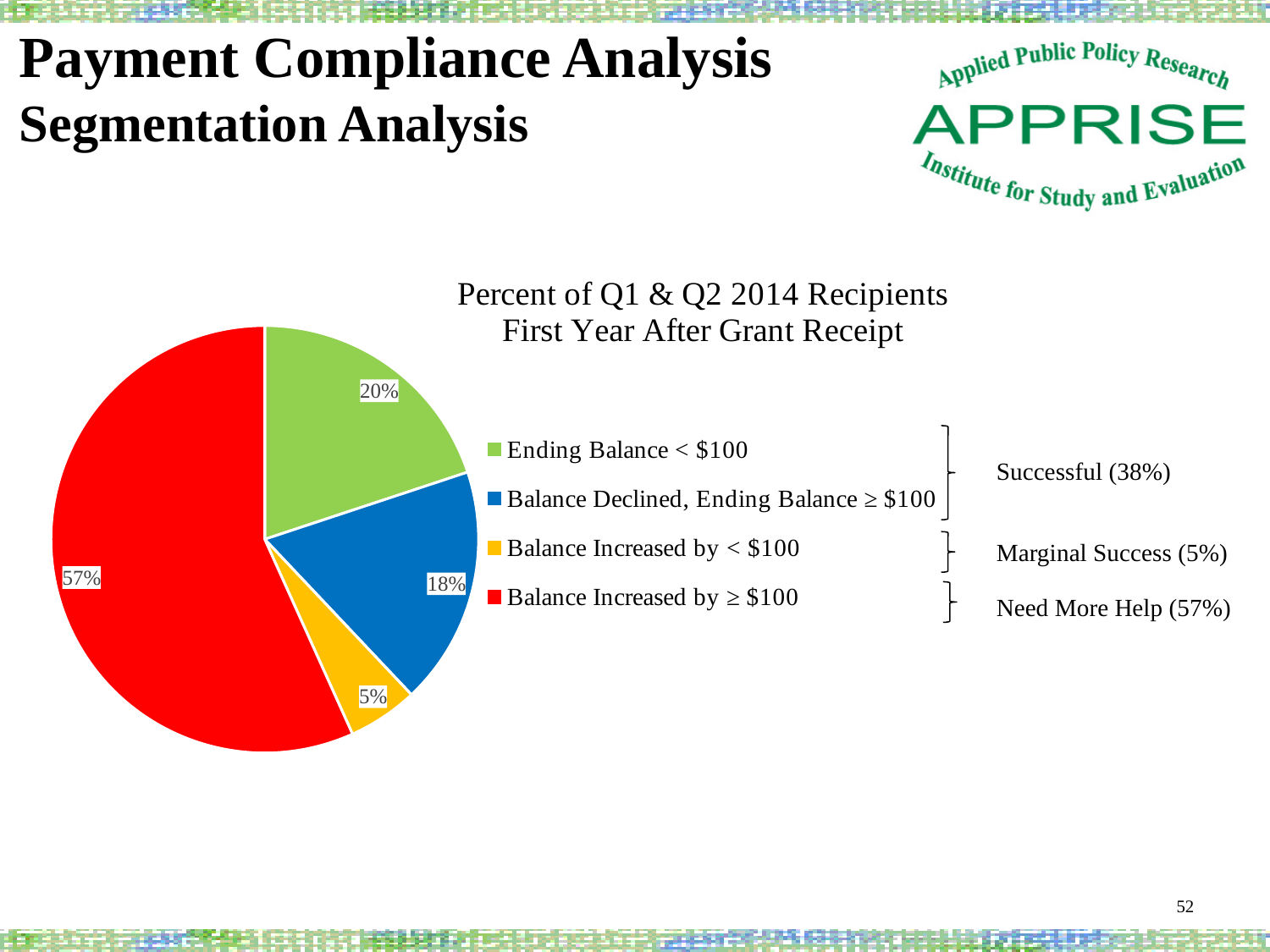
What percentage of recipients had a balance that declined with an ending balance ≥ $100? 18% What percentage of recipients had an ending balance < $100? 20% What kind of chart is shown on the slide? pie chart What colour is the slice for Balance Increased by ≥ $100? red What is the title of the chart? Percent of Q1 & Q2 2014 Recipients First Year After Grant Receipt What percentage of recipients had a balance increased by ≥ $100? 57% How many categories does the legend list? 4 Which category has the largest share of the pie? Balance Increased by ≥ $100 What percentage of recipients had a balance increased by < $100? 5% What is the difference between the share for Balance Increased by ≥ $100 and the share for Ending Balance < $100? 37% Which is larger: the share for Ending Balance < $100 or the share for Balance Declined, Ending Balance ≥ $100? Ending Balance < $100 Which category has the smallest share of the pie? Balance Increased by < $100